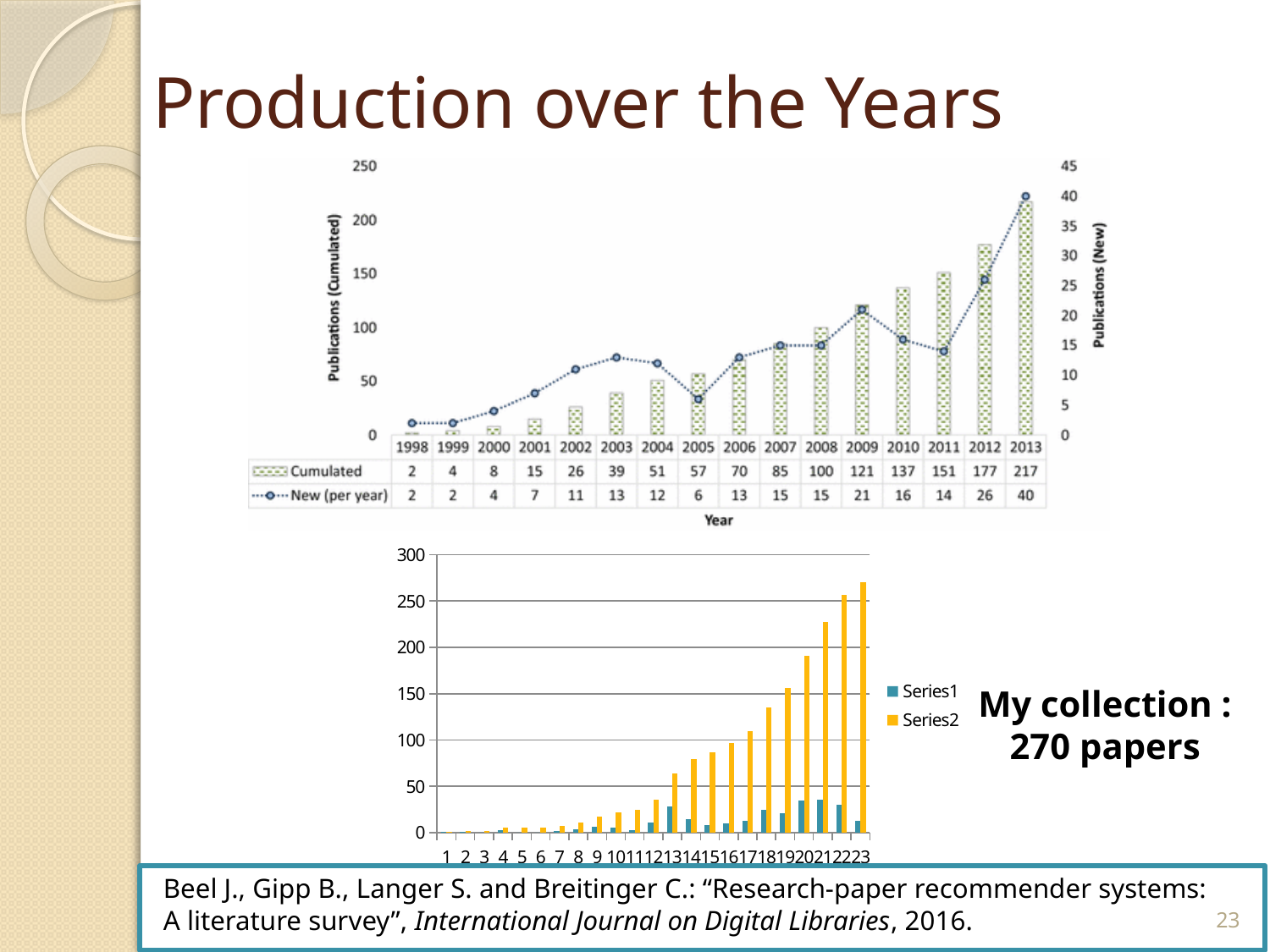
In the top chart, how many years are shown on the x axis? 16 In the bottom chart, which is larger at category 23, Series1 or Series2? Series2 In the top chart, which year has the highest New (per year) value? 2013 In the bottom chart, how many series does the legend list? 2 In the bottom chart, is the Series2 value for category 23 greater or less than 250? greater In the top chart, what is the Cumulated value for 2013? 217 In the top chart, do the Cumulated values rise or fall from 1998 to 2013? rise In the top chart, what is the New (per year) value for 2012? 26 In the top chart, how many series does the legend list? 2 What kind of chart is the bottom chart? bar chart In the top chart, what is the difference between the Cumulated values for 2013 and 2012? 40 In the top chart, which is larger, the New (per year) value for 2009 or for 2010? 2009